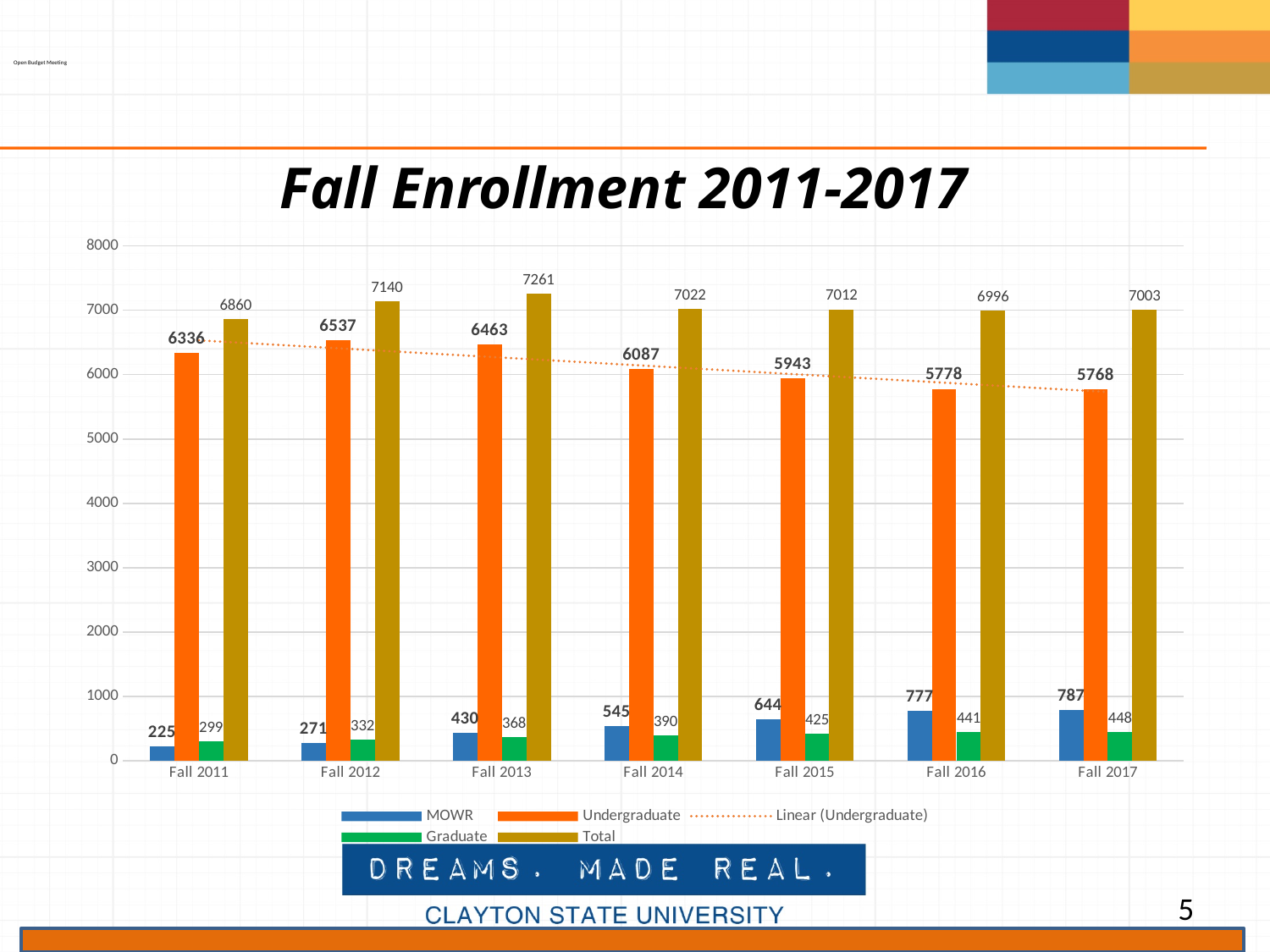
How many entries does the legend list? 5 Which fall term has the lowest Undergraduate enrollment? Fall 2017 What is the Total enrollment for Fall 2013? 7261 What is the Undergraduate enrollment for Fall 2014? 6087 Which is larger, the Graduate enrollment in Fall 2015 or the MOWR enrollment in Fall 2015? MOWR enrollment in Fall 2015 Which fall term has the highest Total enrollment? Fall 2013 What is the difference between the Undergraduate enrollment in Fall 2012 and Fall 2016? 759 Does the MOWR enrollment rise or fall from Fall 2011 to Fall 2017? rise What is the Graduate enrollment for Fall 2011? 299 What is the MOWR value for Fall 2017? 787 What is the title of the chart? Fall Enrollment 2011-2017 How many fall terms are shown on the x axis? 7